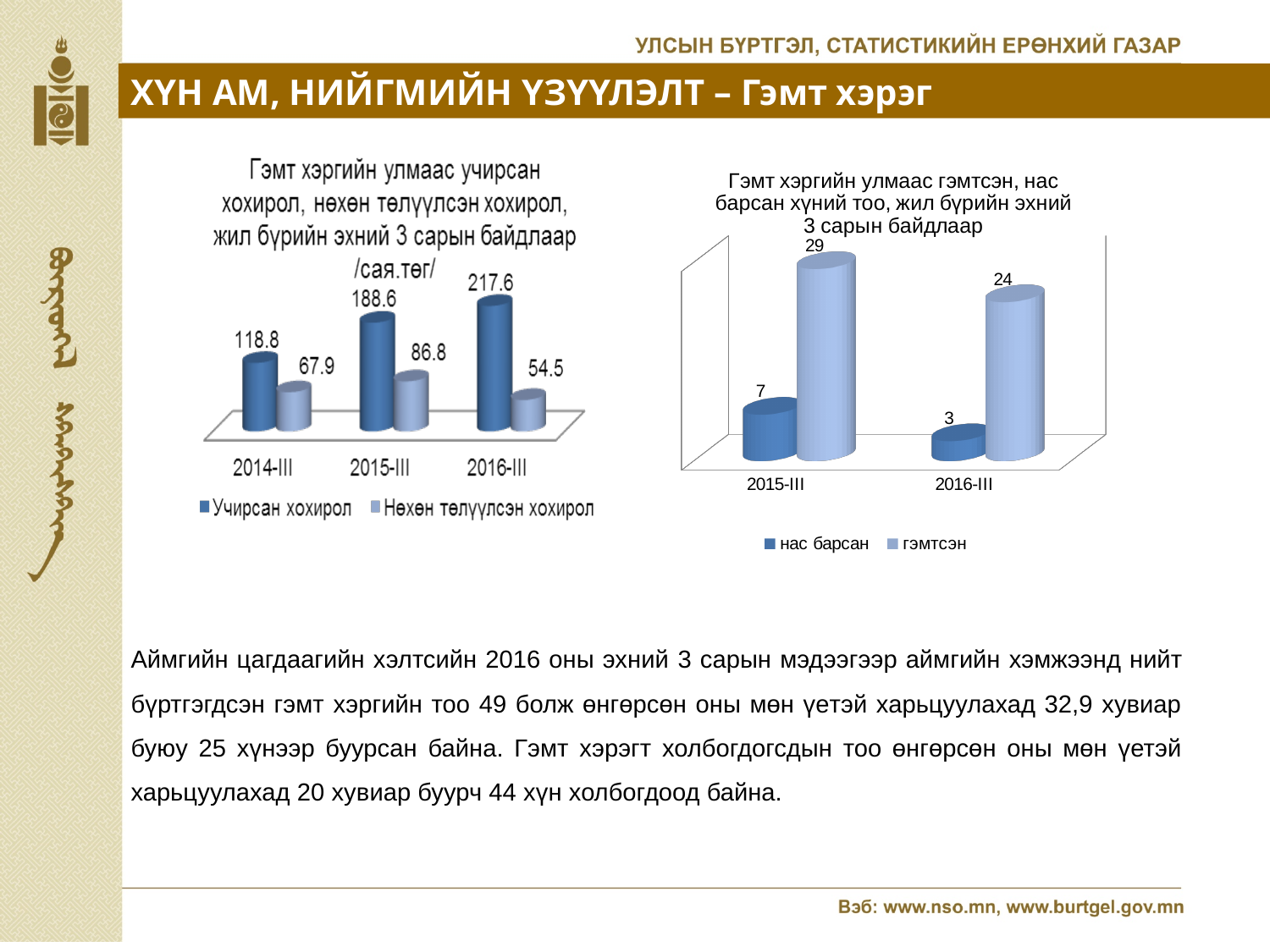
In the left chart (Гэмт хэргийн улмаас учирсан хохирол), what is the value of Учирсан хохирол for 2016-III? 217.6 In the left chart (Гэмт хэргийн улмаас учирсан хохирол), how many periods are shown on the x axis? 3 In the right chart (Гэмт хэргийн улмаас гэмтсэн, нас барсан хүний тоо), what is the value of гэмтсэн for 2015-III? 29 In the left chart (Гэмт хэргийн улмаас учирсан хохирол), which period has the lowest Нөхөн төлүүлсэн хохирол value? 2016-III In the left chart (Гэмт хэргийн улмаас учирсан хохирол), which period has the highest Учирсан хохирол value? 2016-III In the right chart (Гэмт хэргийн улмаас гэмтсэн, нас барсан хүний тоо), how many series does the legend list? 2 In the right chart (Гэмт хэргийн улмаас гэмтсэн, нас барсан хүний тоо), which is larger: нас барсан in 2015-III or нас барсан in 2016-III? 2015-III In the left chart (Гэмт хэргийн улмаас учирсан хохирол), what is the value of Нөхөн төлүүлсэн хохирол for 2015-III? 86.8 In the right chart (Гэмт хэргийн улмаас гэмтсэн, нас барсан хүний тоо), what is the value of нас барсан for 2016-III? 3 In the left chart (Гэмт хэргийн улмаас учирсан хохирол), what is the difference between Учирсан хохирол and Нөхөн төлүүлсэн хохирол in 2014-III? 50.9 In the left chart (Гэмт хэргийн улмаас учирсан хохирол), does Учирсан хохирол rise or fall from 2014-III to 2016-III? rise In the right chart (Гэмт хэргийн улмаас гэмтсэн, нас барсан хүний тоо), what is the difference between гэмтсэн in 2015-III and 2016-III? 5